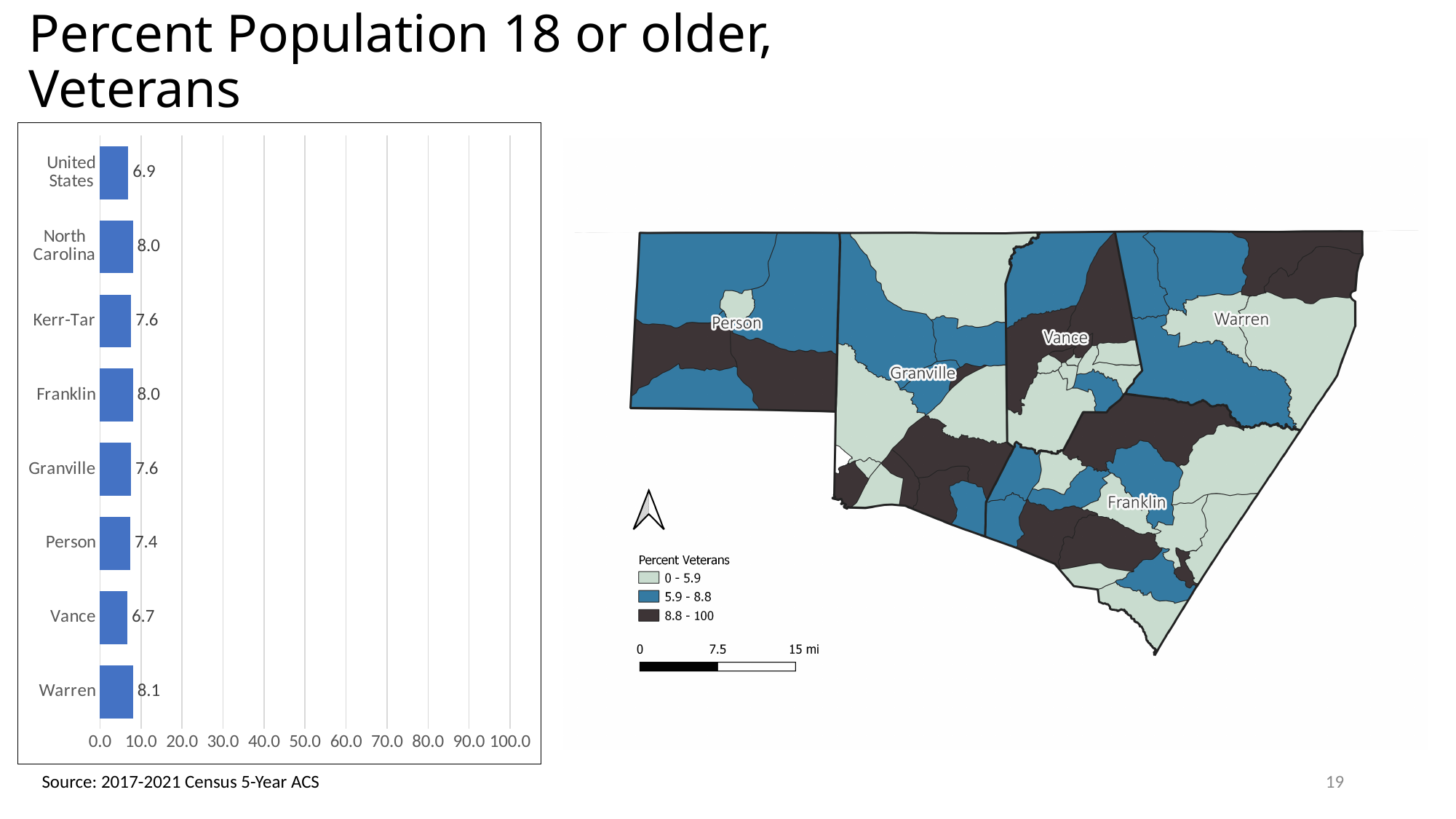
Which category has the lowest value in the bar chart? Vance What is the difference between the values for North Carolina and the United States in the bar chart? 1.1 What is the value for Person in the bar chart? 7.4 What kind of chart is shown on the left of the slide? Bar chart What is the value for Vance in the bar chart? 6.7 How many categories are shown in the bar chart? 8 Is the value for Franklin in the bar chart greater or less than 10.0? less Which category has the highest value in the bar chart? Warren Which has a larger value in the bar chart, Person or Granville? Granville What is the difference between the values for Warren and Vance in the bar chart? 1.4 What is the value for Warren in the bar chart? 8.1 What is the value for the United States in the bar chart? 6.9